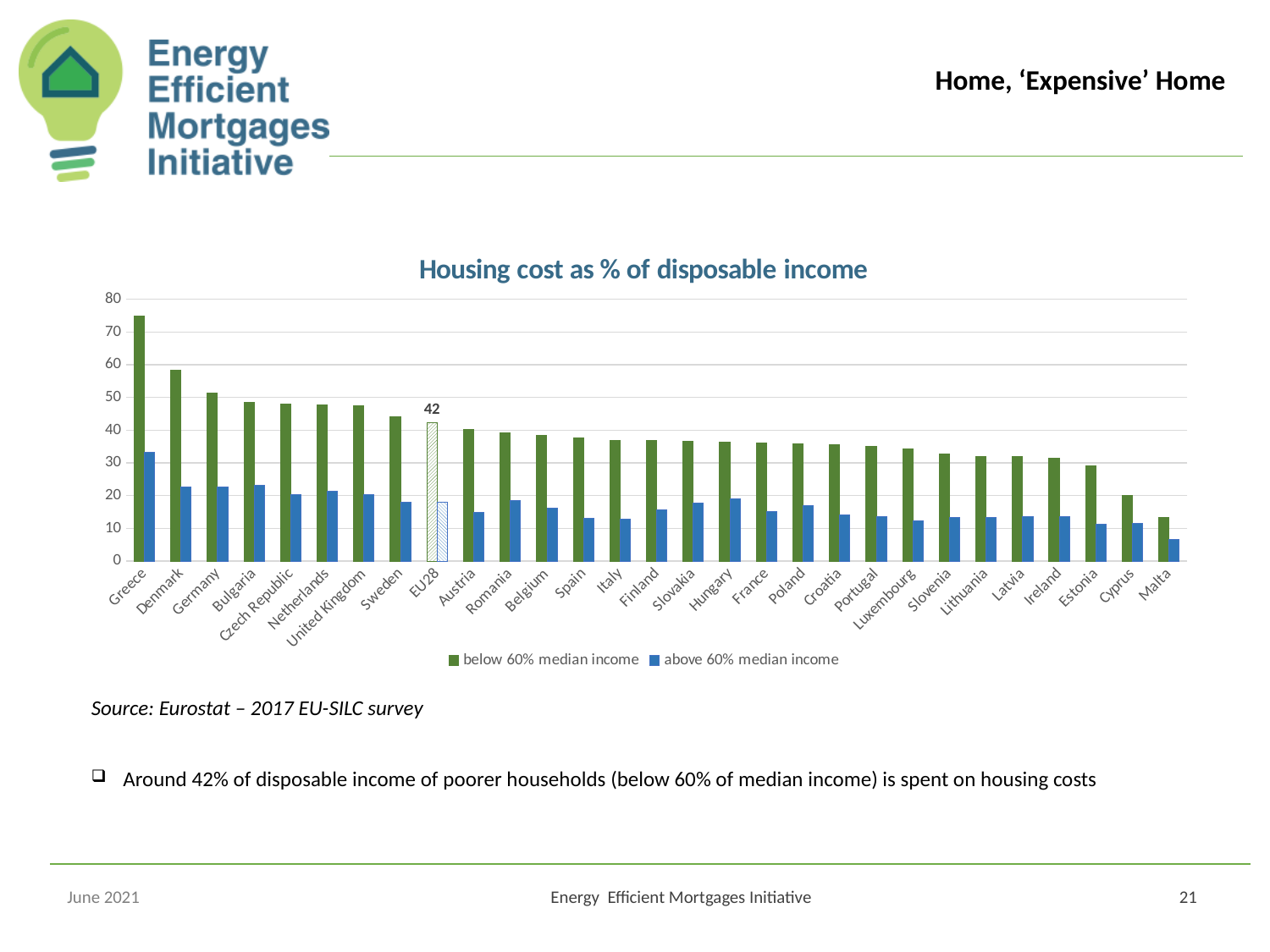
How many categories are shown on the x axis of the chart? 29 Do the 'below 60% median income' values rise or fall moving from left to right along the x axis? fall What is the title of the chart? Housing cost as % of disposable income Which has the larger 'below 60% median income' value, Greece or Denmark? Greece Which category has the highest value in the 'above 60% median income' series? Greece What kind of chart is shown on the slide? bar chart Which category has the lowest value in the 'below 60% median income' series? Malta How many series does the legend list? 2 What is the value for EU28 in the 'below 60% median income' series? 42 Is the 'below 60% median income' value for Greece greater or less than 70? greater Is the 'below 60% median income' value for Malta greater or less than 20? less Which category has the highest value in the 'below 60% median income' series? Greece